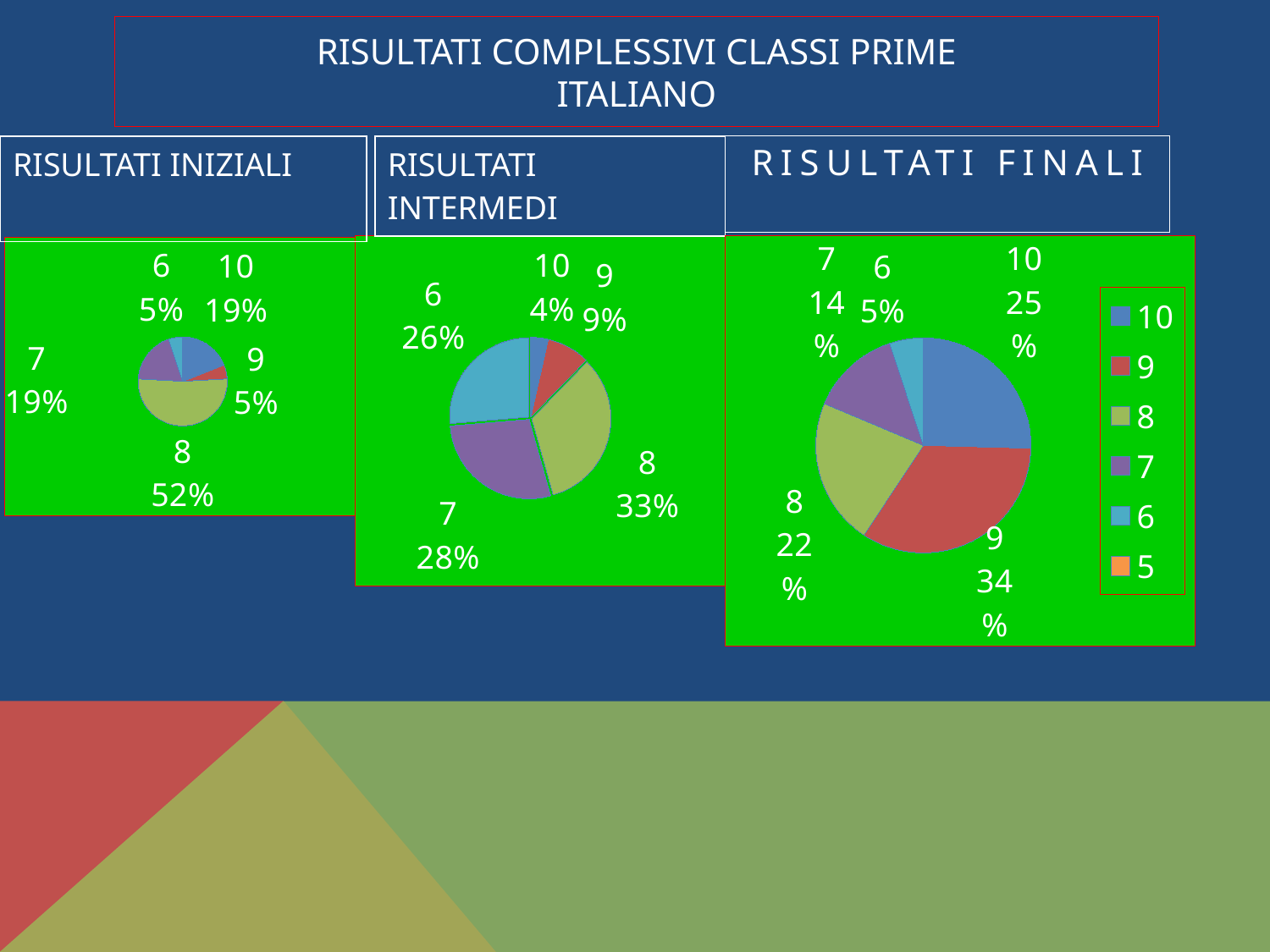
In the RISULTATI INTERMEDI pie chart, what is the difference between the shares of grade 8 and grade 6? 7% In the RISULTATI FINALI pie chart, which is larger, the share of grade 10 or the share of grade 8? 10 In the RISULTATI INIZIALI pie chart, what share does grade 8 have? 52% What kind of chart is used for RISULTATI INTERMEDI? Pie chart In the RISULTATI FINALI pie chart, what share does grade 9 have? 34% In the RISULTATI INIZIALI pie chart, which grade has the largest share? 8 In the RISULTATI INTERMEDI pie chart, which grade has the smallest share? 10 In the RISULTATI INTERMEDI pie chart, what share does grade 7 have? 28% How many entries does the legend of the RISULTATI FINALI chart list? 6 In the RISULTATI INIZIALI pie chart, what share does grade 10 have? 19% What is the title of the slide? RISULTATI COMPLESSIVI CLASSI PRIME ITALIANO In the RISULTATI FINALI pie chart, which grade has the largest share? 9